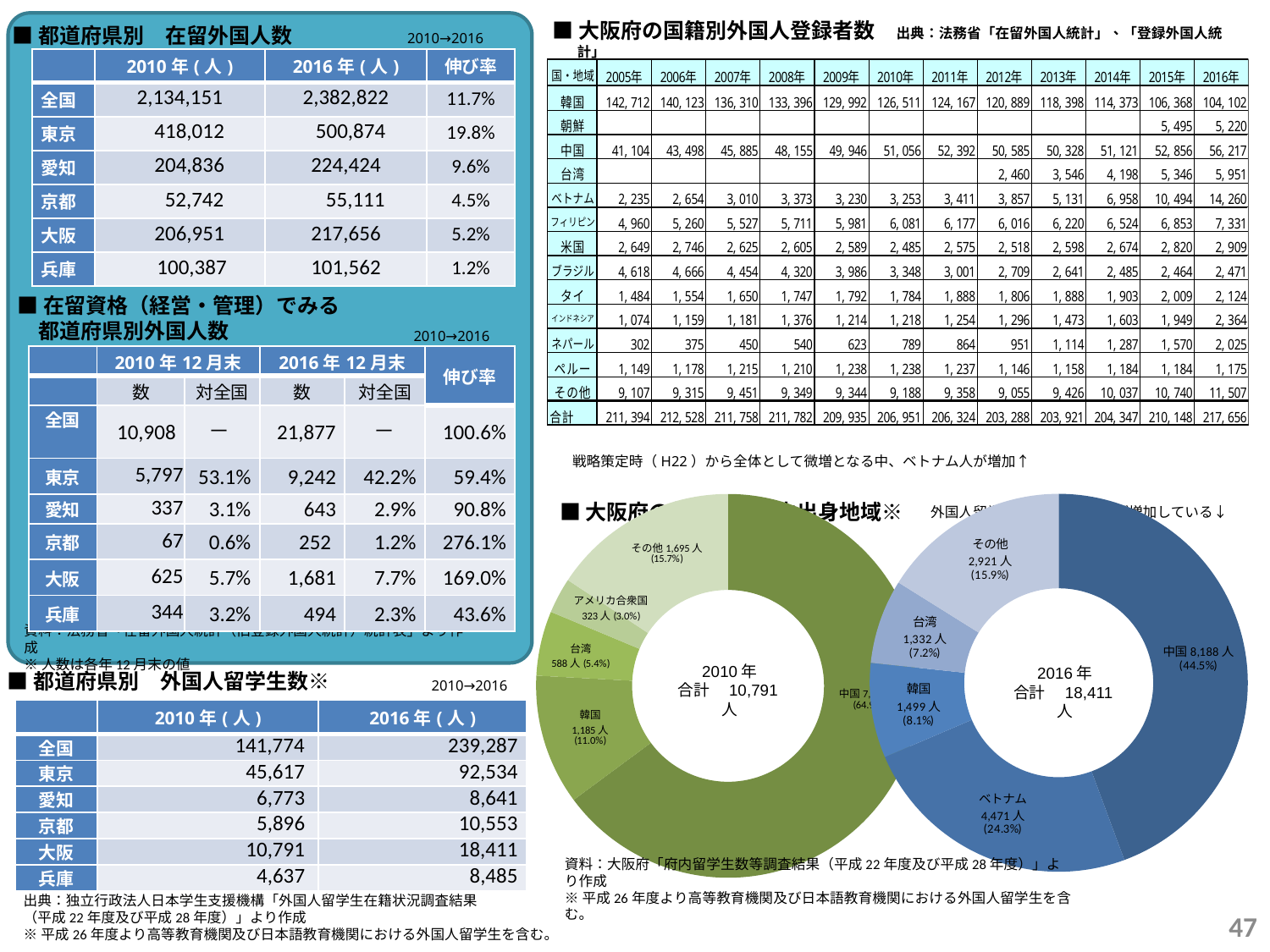
In the 2016 donut chart (right), how many labelled slices are there? 5 In the 2010 donut chart (left), what share of the total is その他? 15.7% In the 2010 donut chart (left), which labelled region has the smallest slice? アメリカ合衆国 In the 2010 donut chart (left), what is the total number of foreign students shown in the centre? 10,791人 In the 2010 donut chart (left), how many students came from 韓国? 1,185人 In the 2016 donut chart (right), which region has the largest slice? 中国 In the 2016 donut chart (right), what is the total number of foreign students shown in the centre? 18,411人 In the 2016 donut chart (right), which is larger, the number of students from 韓国 or from 台湾? 韓国 What type of chart is used to show the origin regions of foreign students in Osaka for 2010 and 2016? Pie (donut) chart In the 2016 donut chart (right), what is the difference between the number of students from 中国 and from ベトナム? 3,717人 In the 2016 donut chart (right), what share of the total do students from ベトナム represent? 24.3% In the 2016 donut chart (right), how many foreign students came from 中国? 8,188人